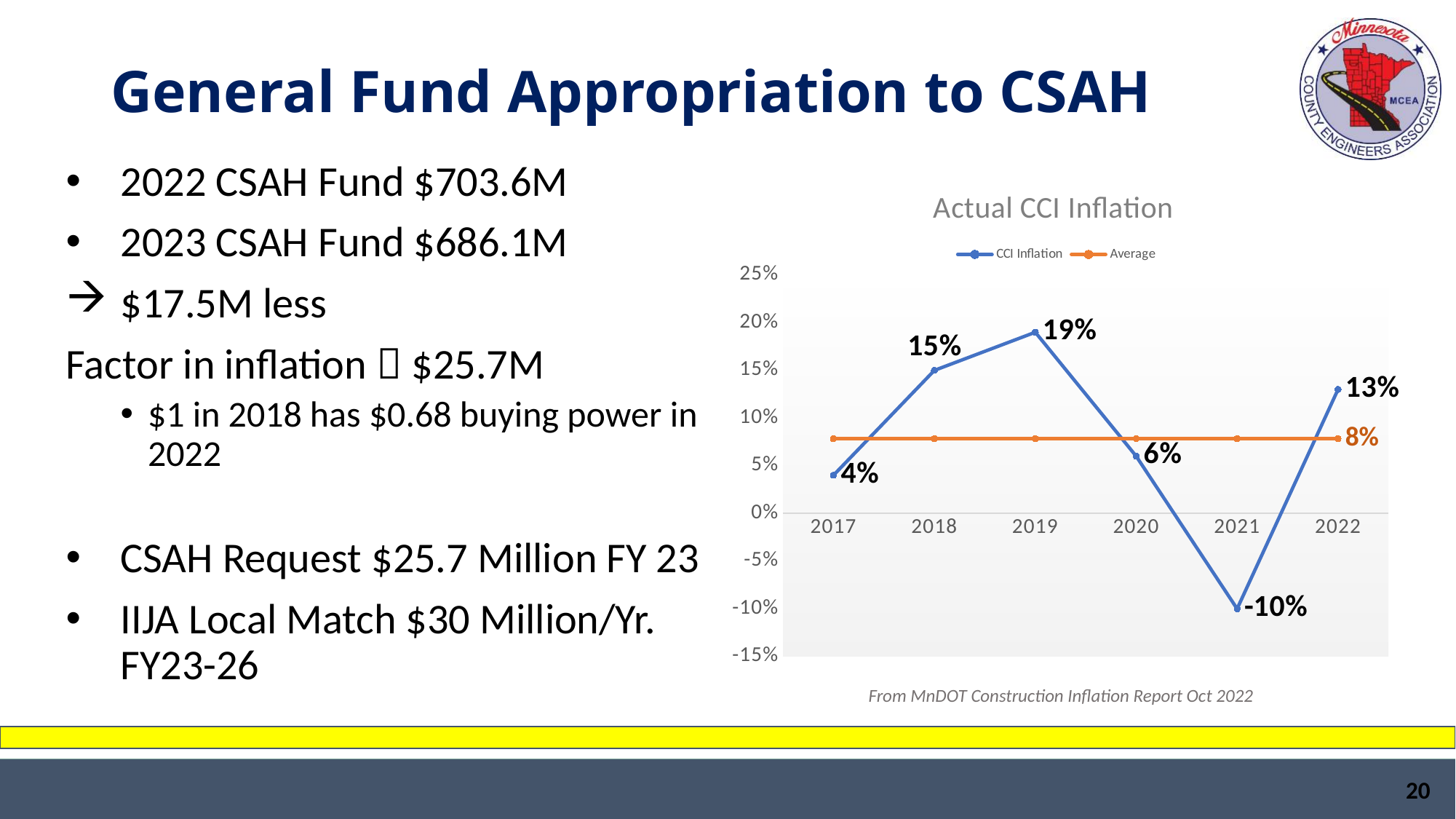
What is the Average value shown on the chart? 8% Which year has the highest CCI Inflation? 2019 What is the CCI Inflation value for 2019? 19% Which year has the lowest CCI Inflation? 2021 What is the CCI Inflation value for 2021? -10% Which is larger, the CCI Inflation for 2022 or for 2020? 2022 What type of chart is shown on the slide? line chart Does CCI Inflation rise or fall from 2019 to 2021? fall How many years are plotted on the x axis of the chart? 6 What is the difference between the CCI Inflation values for 2019 and 2018? 4% How many series does the chart legend list? 2 What is the title of the chart? Actual CCI Inflation